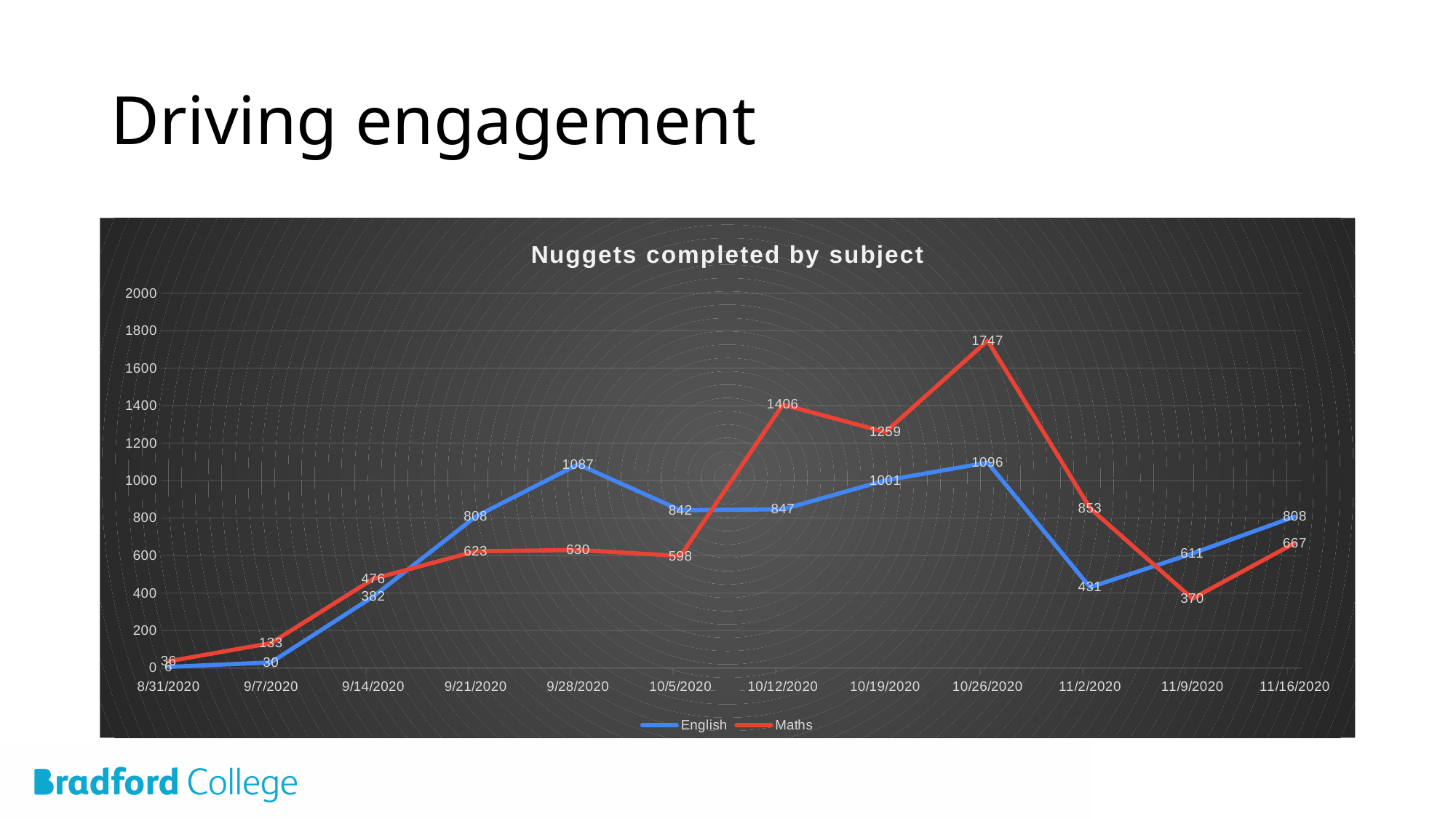
What is the Maths value on 10/26/2020? 1747 What kind of chart is shown on the slide? line chart How many series does the legend list? 2 What is the English value on 9/28/2020? 1087 How many dates are plotted along the x axis? 12 On 10/5/2020, which series has the larger value, English or Maths? English What is the title of the chart? Nuggets completed by subject What is the difference between the Maths and English values on 10/26/2020? 651 What is the Maths value on 11/9/2020? 370 On which date does the English series reach its highest value? 10/26/2020 On which date does the Maths series reach its highest value? 10/26/2020 On which date is the Maths value lowest? 8/31/2020